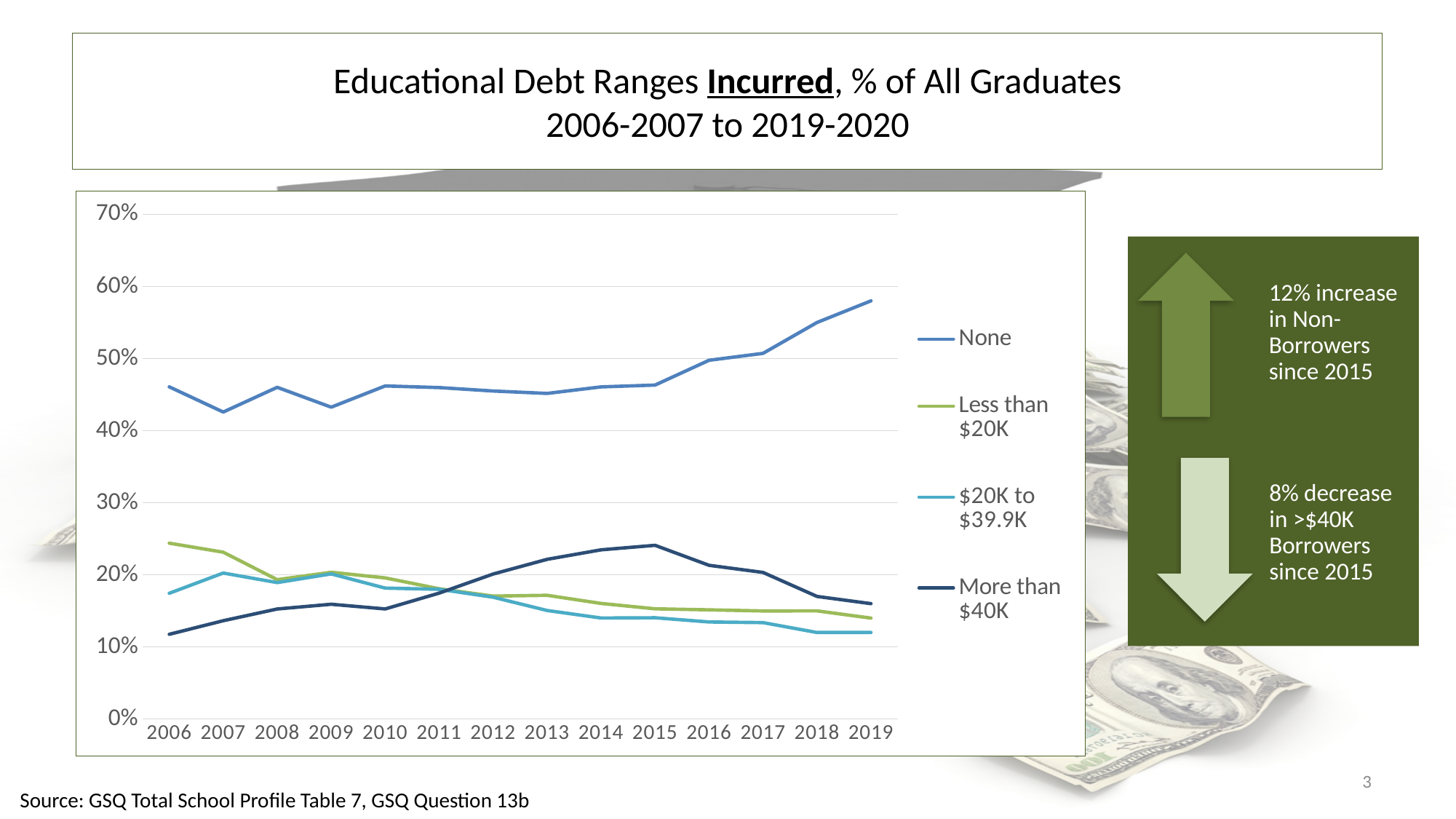
What kind of chart is shown on the slide? Line chart Is the value for None in 2019 greater or less than 50%? greater Is the value for More than $40K in 2006 greater or less than 20%? less Which series has the lowest value in 2006? More than $40K In 2015, which is larger: More than $40K or Less than $20K? More than $40K How many series does the chart's legend list? 4 Does the None series generally rise or fall from 2006 to 2019? Rise How many years are shown along the x axis of the chart? 14 Is the value for Less than $20K in 2006 greater or less than 20%? greater What is the title of the slide's chart? Educational Debt Ranges Incurred, % of All Graduates 2006-2007 to 2019-2020 Which series has the lowest value in 2019? $20K to $39.9K Which series has the highest value in 2019? None